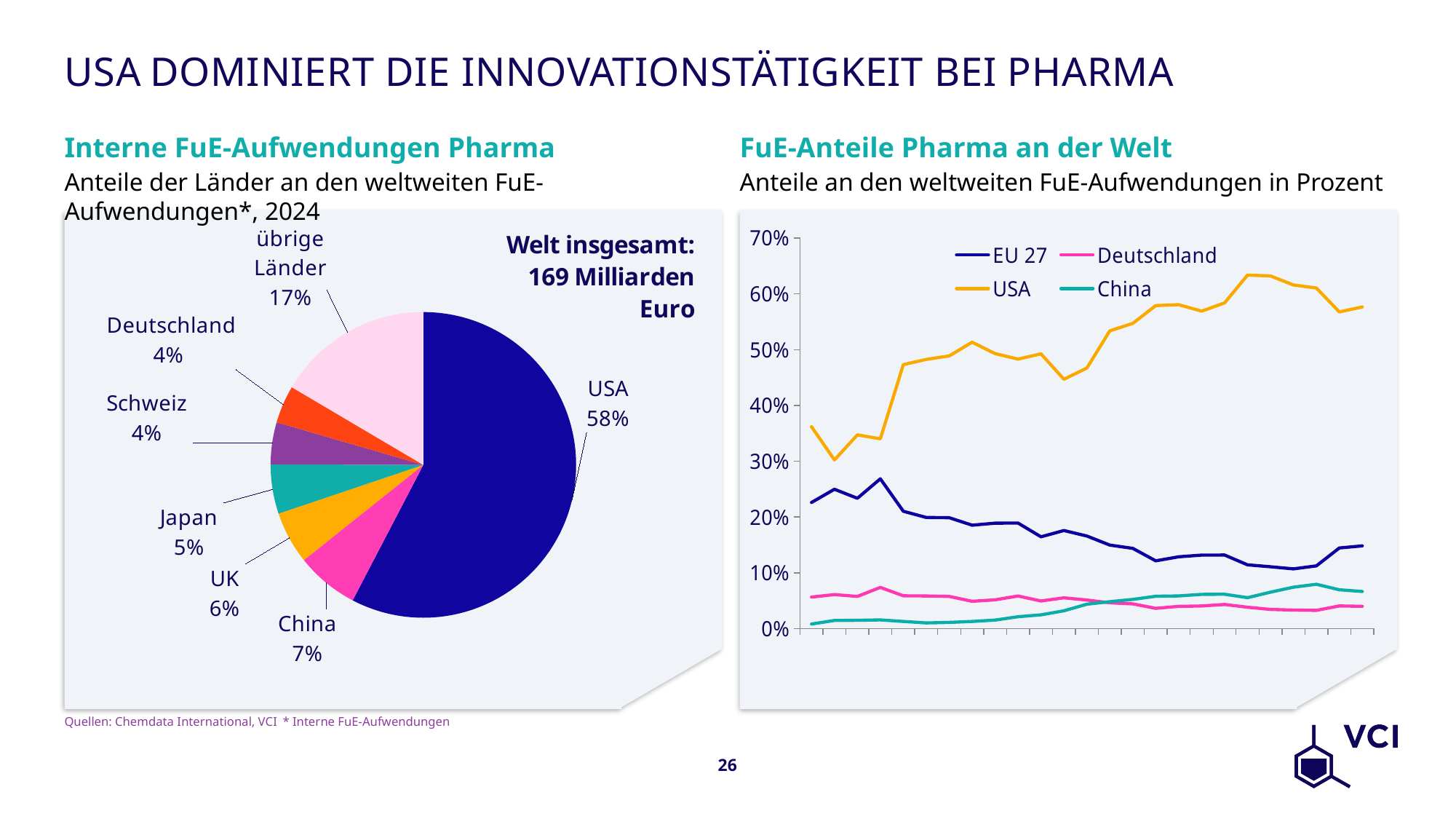
In the pie chart 'Interne FuE-Aufwendungen Pharma', which named country has the largest share? USA In the pie chart 'Interne FuE-Aufwendungen Pharma', what is the difference in percentage points between the USA share and the China share? 51 percentage points In the pie chart 'Interne FuE-Aufwendungen Pharma', what share is attributed to 'übrige Länder'? 17% In the line chart 'FuE-Anteile Pharma an der Welt', does the EU 27 series generally rise or fall from left to right? Fall In the pie chart 'Interne FuE-Aufwendungen Pharma', what is the world total stated on the chart? 169 Milliarden Euro In the pie chart 'Interne FuE-Aufwendungen Pharma', what share does China hold? 7% How many series does the legend of the line chart 'FuE-Anteile Pharma an der Welt' list? 4 In the line chart 'FuE-Anteile Pharma an der Welt', is the last value of the USA series greater or less than 50%? greater What kind of chart is 'FuE-Anteile Pharma an der Welt'? Line chart In the pie chart 'Interne FuE-Aufwendungen Pharma', which has the larger share, UK or Japan? UK In the pie chart 'Interne FuE-Aufwendungen Pharma', what share does the USA hold? 58% In the pie chart 'Interne FuE-Aufwendungen Pharma', how many slices does the pie have? 7